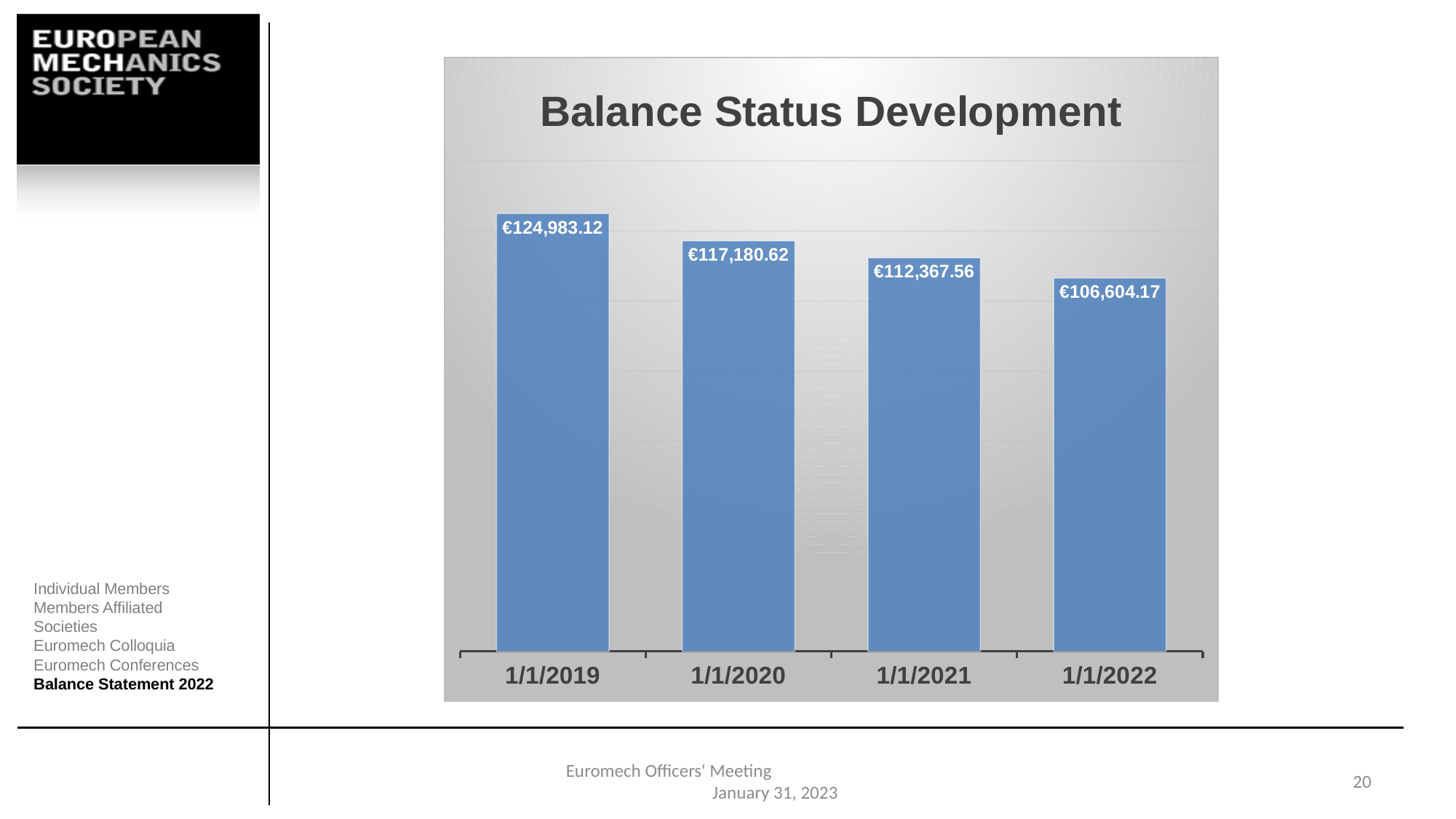
How many dates are shown on the x axis? 4 What is the value shown for 1/1/2021? €112,367.56 Which date has the lowest balance? 1/1/2022 What is the difference between the balance on 1/1/2019 and on 1/1/2020? €7,802.50 Which is larger, the balance on 1/1/2020 or on 1/1/2021? 1/1/2020 What kind of chart is this? Bar chart Which date has the highest balance? 1/1/2019 What is the difference between the balance on 1/1/2019 and on 1/1/2022? €18,378.95 What is the value shown for 1/1/2022? €106,604.17 What is the value shown for 1/1/2019? €124,983.12 Do the balance values rise or fall from 1/1/2019 to 1/1/2022? Fall What is the value shown for 1/1/2020? €117,180.62